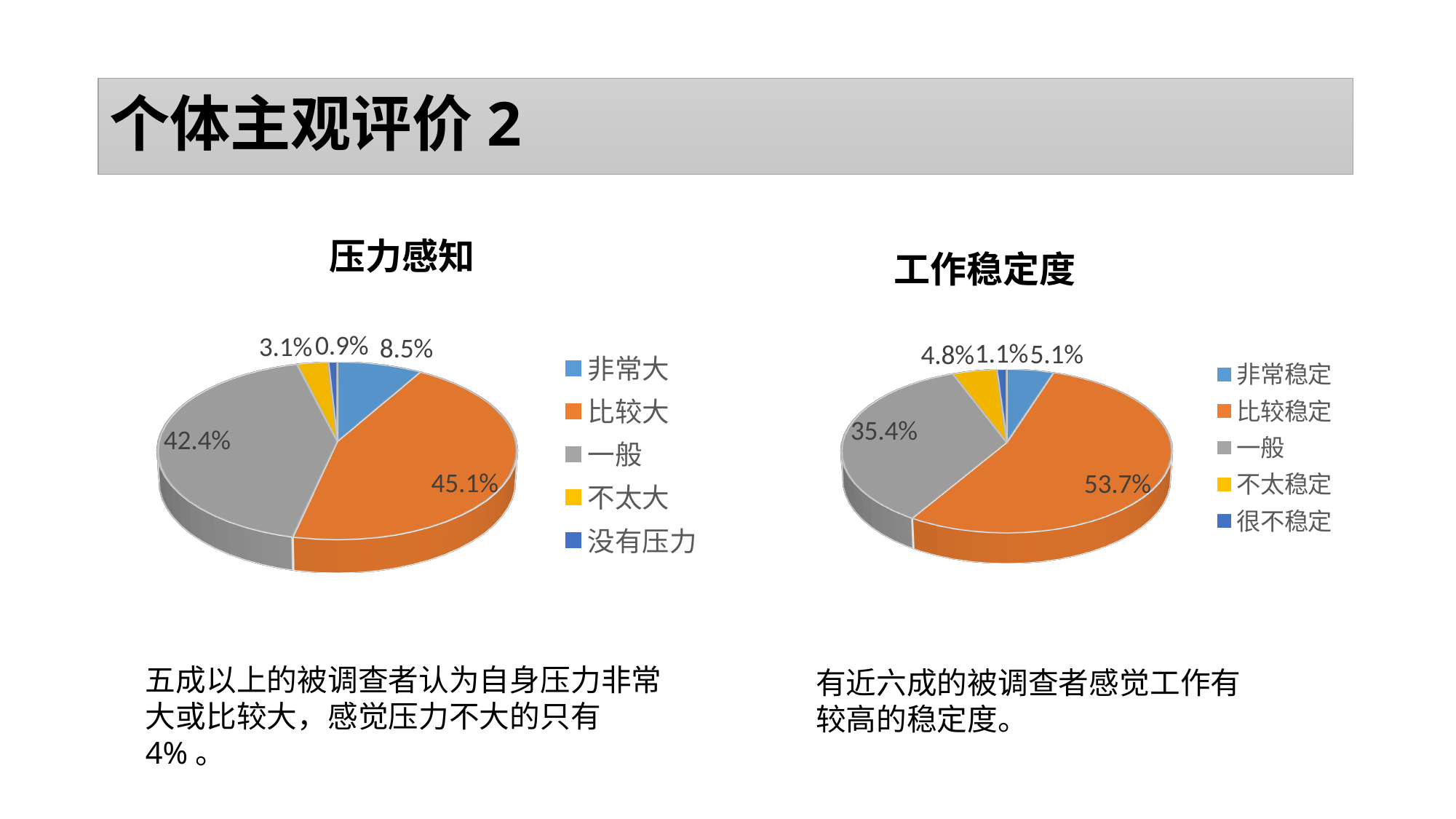
In the 工作稳定度 chart, what is the difference between the shares for 比较稳定 and 一般? 18.3% What type of chart is the 工作稳定度 chart? Pie chart In the 工作稳定度 chart, what percentage of respondents chose 不太稳定? 4.8% In the 压力感知 chart, which category has the smallest share? 没有压力 In the 压力感知 chart, what percentage of respondents chose 比较大? 45.1% In the 工作稳定度 chart, which category has the largest share? 比较稳定 In the 工作稳定度 chart, what percentage of respondents chose 比较稳定? 53.7% In the 压力感知 chart, which category has the largest share? 比较大 In the 压力感知 chart, what is the difference between the shares for 比较大 and 一般? 2.7% In the 压力感知 chart, what percentage of respondents chose 非常大? 8.5% In the 工作稳定度 chart, which is larger, the share for 非常稳定 or the share for 不太稳定? 非常稳定 How many categories does the legend of the 压力感知 chart list? 5